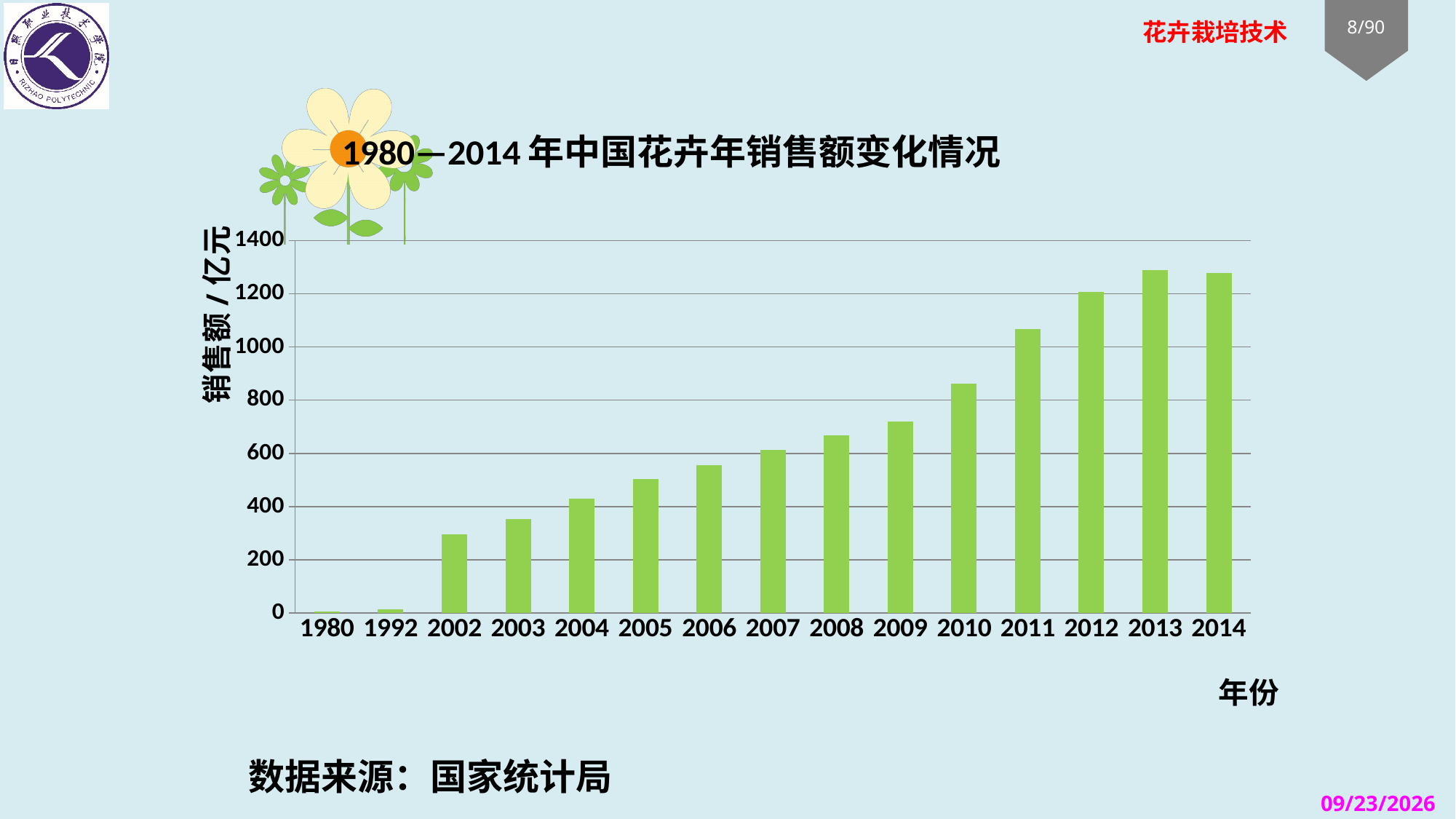
Which year has the lowest sales value in the chart? 1980 Do the values generally rise or fall from 2002 to 2013? rise Is the value for 2002 greater or less than 400? less Is the value for 2011 greater or less than 1000? greater Which year has the larger value, 2010 or 2011? 2011 What is the title of the chart? 1980—2014年中国花卉年销售额变化情况 How many years are shown on the x axis of the chart? 15 What kind of chart is shown on the slide? bar chart Is the value for 2005 greater or less than 400? greater Which year has the larger value, 2003 or 2006? 2006